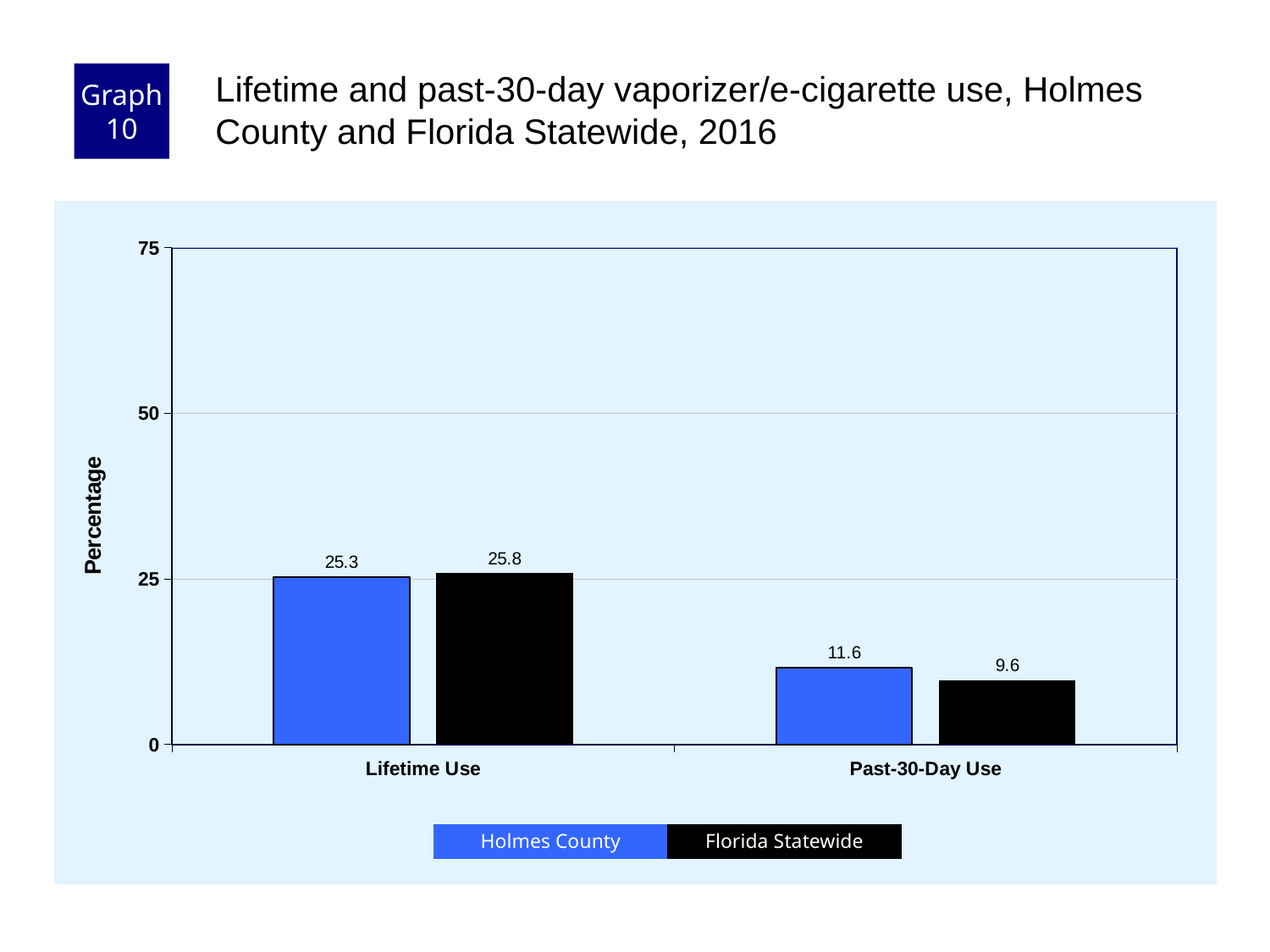
How many categories are shown on the x axis? 2 Which category has the highest value for Holmes County? Lifetime Use What is the Lifetime Use value for Florida Statewide? 25.8 What is the Lifetime Use value for Holmes County? 25.3 What is the Past-30-Day Use value for Florida Statewide? 9.6 What is the difference between the Holmes County and Florida Statewide values for Past-30-Day Use? 2.0 What kind of chart is shown on the slide? bar chart What is the Past-30-Day Use value for Holmes County? 11.6 Is the Lifetime Use value for Holmes County greater or less than 50? less For Past-30-Day Use, which is larger: Holmes County or Florida Statewide? Holmes County How many series does the legend list? 2 Which category has the lowest value for Florida Statewide? Past-30-Day Use